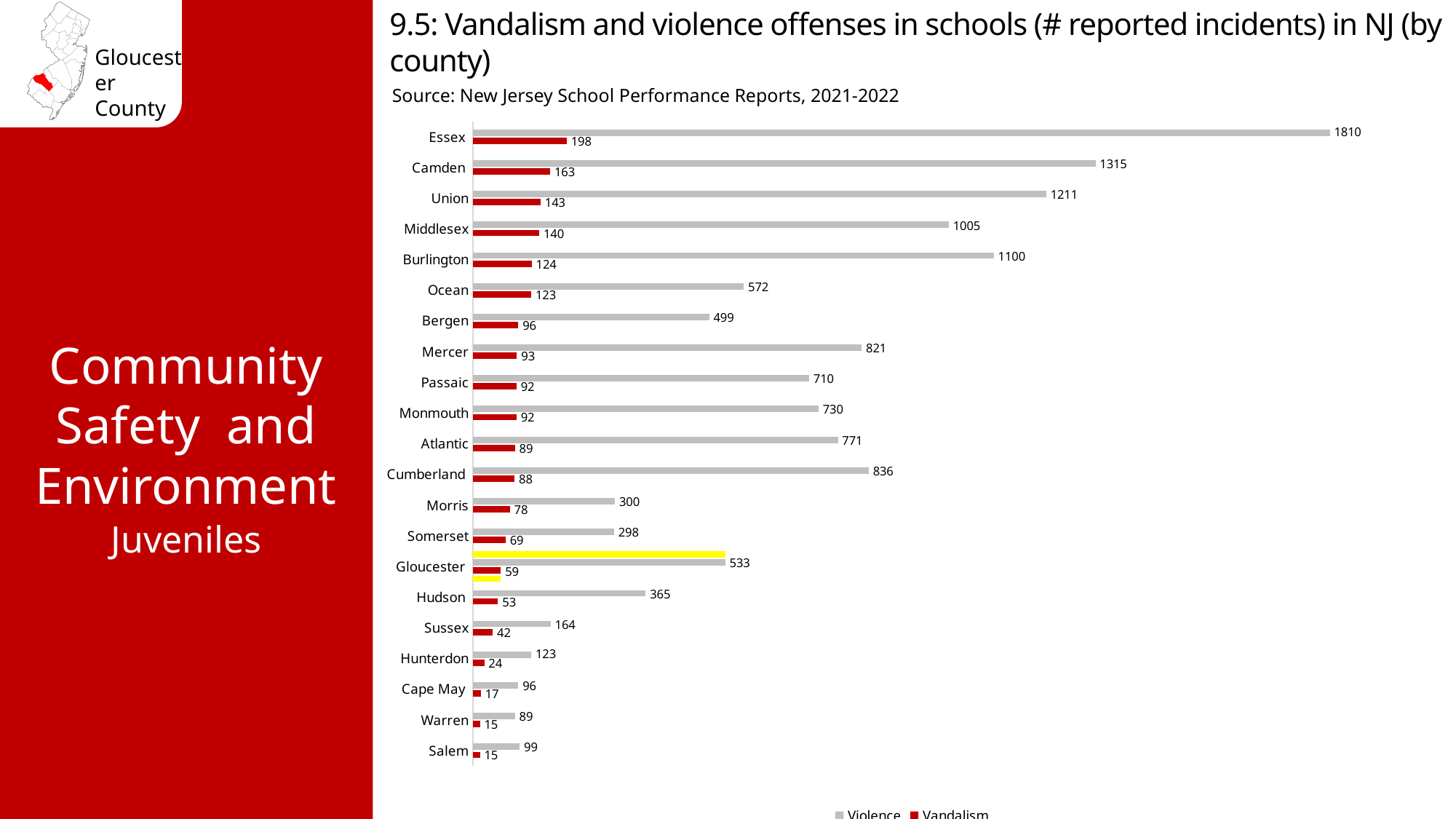
Which series is shown in red in the chart? Vandalism Which county has the highest number of reported violence incidents? Essex Which county has the lowest number of reported violence incidents? Warren What is the difference between violence and vandalism incidents in Gloucester County? 474 How many counties are shown in the chart? 21 What is the number of reported vandalism incidents in Camden County? 163 What is the number of reported violence incidents in Gloucester County? 533 Which county has more reported violence incidents, Burlington or Middlesex? Burlington How many series does the legend list? 2 Which county has the highest number of reported vandalism incidents? Essex What kind of chart is shown on the slide? Bar chart What is the difference between the violence incidents in Essex and Camden? 495